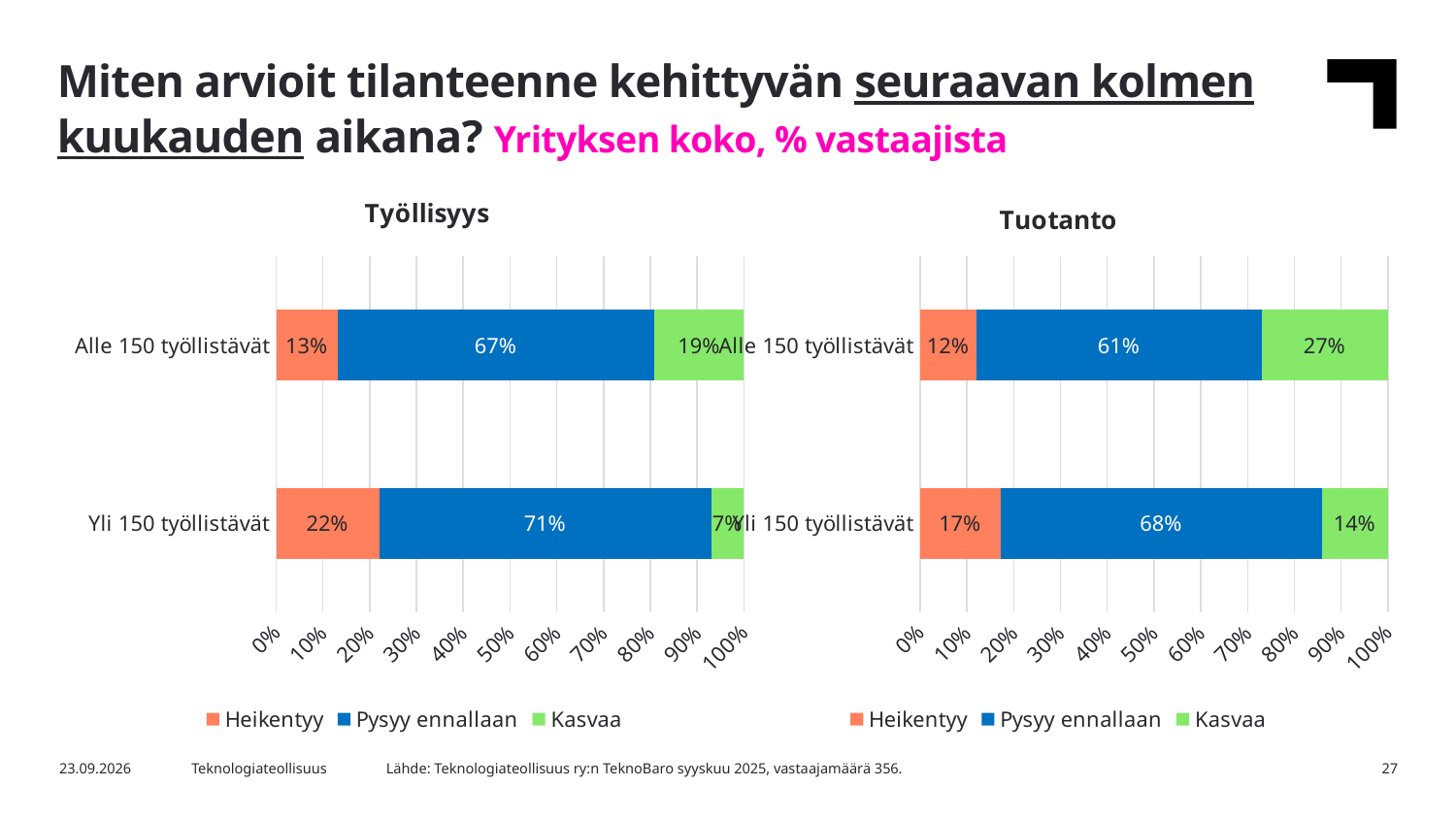
In the Tuotanto chart, what is the Kasvaa value for Alle 150 työllistävät? 27% In the Työllisyys chart, what is the Pysyy ennallaan value for Alle 150 työllistävät? 67% In the Työllisyys chart, which category has the highest Pysyy ennallaan value? Yli 150 työllistävät In the Tuotanto chart, what is the Pysyy ennallaan value for Yli 150 työllistävät? 68% In the Tuotanto chart, what is the total of the stacked bar for Alle 150 työllistävät? 100% In the Työllisyys chart, what is the Heikentyy value for Yli 150 työllistävät? 22% How many categories are shown in the Työllisyys chart? 2 How many series does the legend of the Tuotanto chart list? 3 In the Työllisyys chart, what is the difference between the Kasvaa values for Alle 150 työllistävät and Yli 150 työllistävät? 12 percentage points In the Tuotanto chart, which category has the lowest Kasvaa value? Yli 150 työllistävät In the Tuotanto chart, which category has the larger Heikentyy value, Alle 150 työllistävät or Yli 150 työllistävät? Yli 150 työllistävät What kind of chart is the Työllisyys chart? Stacked bar chart